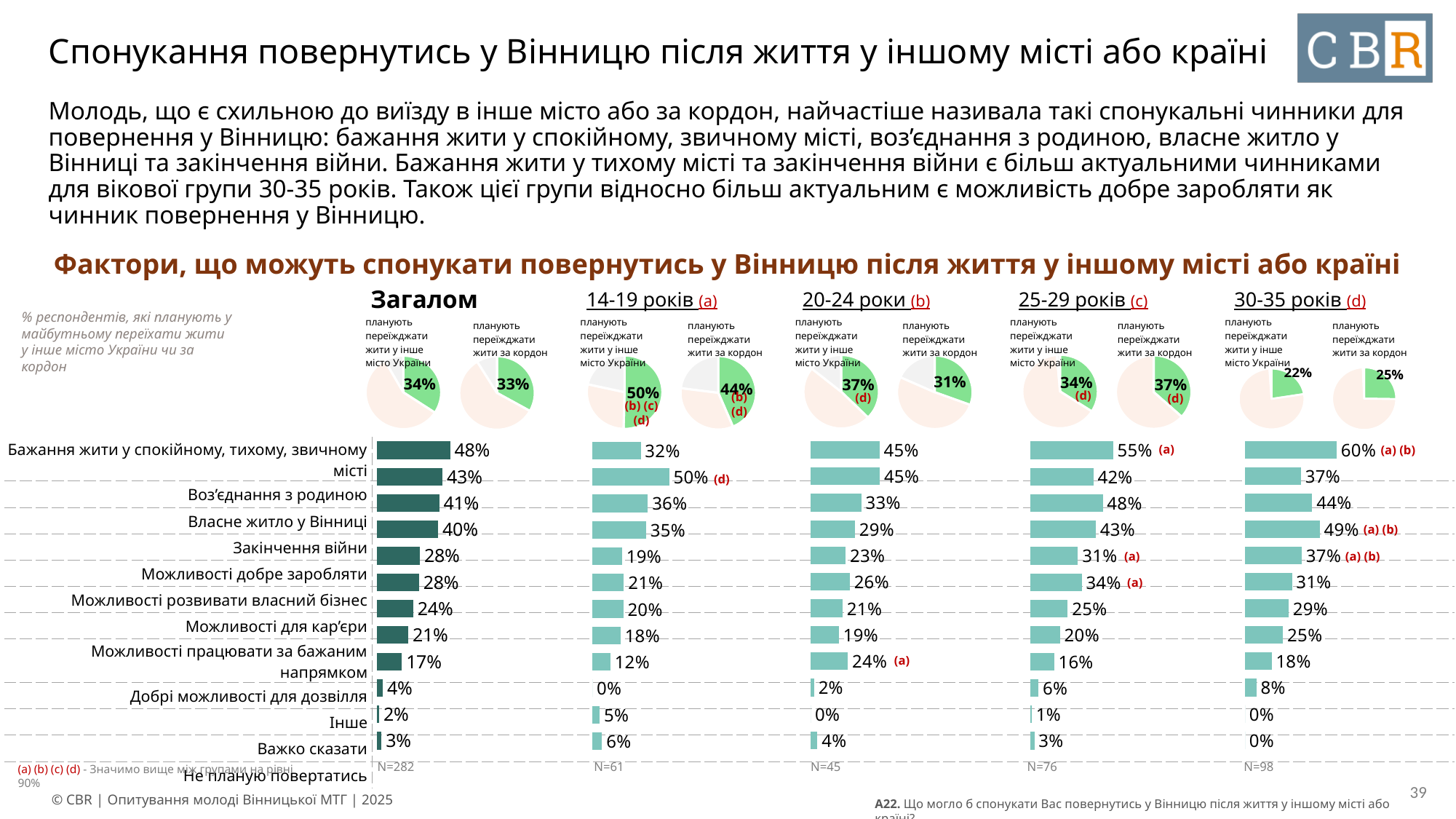
For 'Бажання жити у спокійному, тихому, звичному місті', which age group has the larger value: 25-29 років or 20-24 роки? 25-29 років What is the difference between the 30-35 років and 14-19 років values for 'Бажання жити у спокійному, тихому, звичному місті'? 28 percentage points What kind of charts are used to show the factors by age group? Bar charts In the Загалом bar chart, what is the value for 'Бажання жити у спокійному, тихому, звичному місті'? 48% What is the sample size (N) shown for the 30-35 років group? N=98 In the 30-35 років pie charts, what share plans to move abroad? 25% In the 14-19 років bar chart, what is the value for 'Бажання жити у спокійному, тихому, звичному місті'? 32% In the 30-35 років bar chart, what is the value for 'Бажання жити у спокійному, тихому, звичному місті'? 60% What is the lowest value shown in the Загалом bar chart? 2% What is the highest value shown in the 25-29 років bar chart? 55% How many categories (bars) are shown in the Загалом bar chart? 12 In the 14-19 років pie charts, what share plans to move to another city of Ukraine? 50%